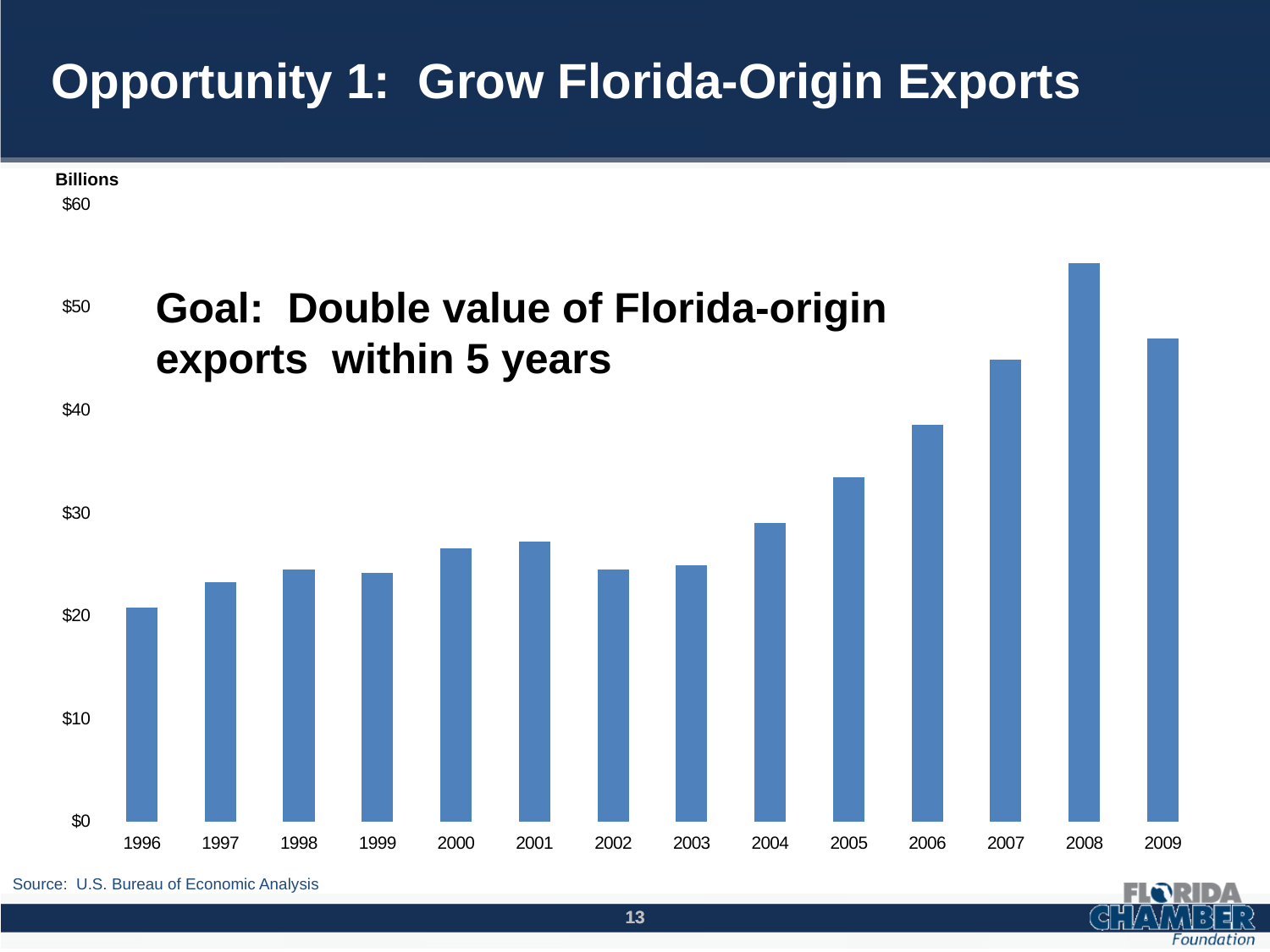
Do the values generally rise or fall from 2003 to 2008? rise What unit is the vertical axis labelled in? Billions What kind of chart is shown on the slide? bar chart Is the value for 2009 greater or less than $50? less Which year has the larger value, 2004 or 2005? 2005 Which year has the larger value, 2007 or 2009? 2009 Is the value for 2006 greater or less than $30? greater Is the value for 1996 greater or less than $30? less Which year has the lowest value on the chart? 1996 Which year has the highest value on the chart? 2008 How many years are plotted on the chart? 14